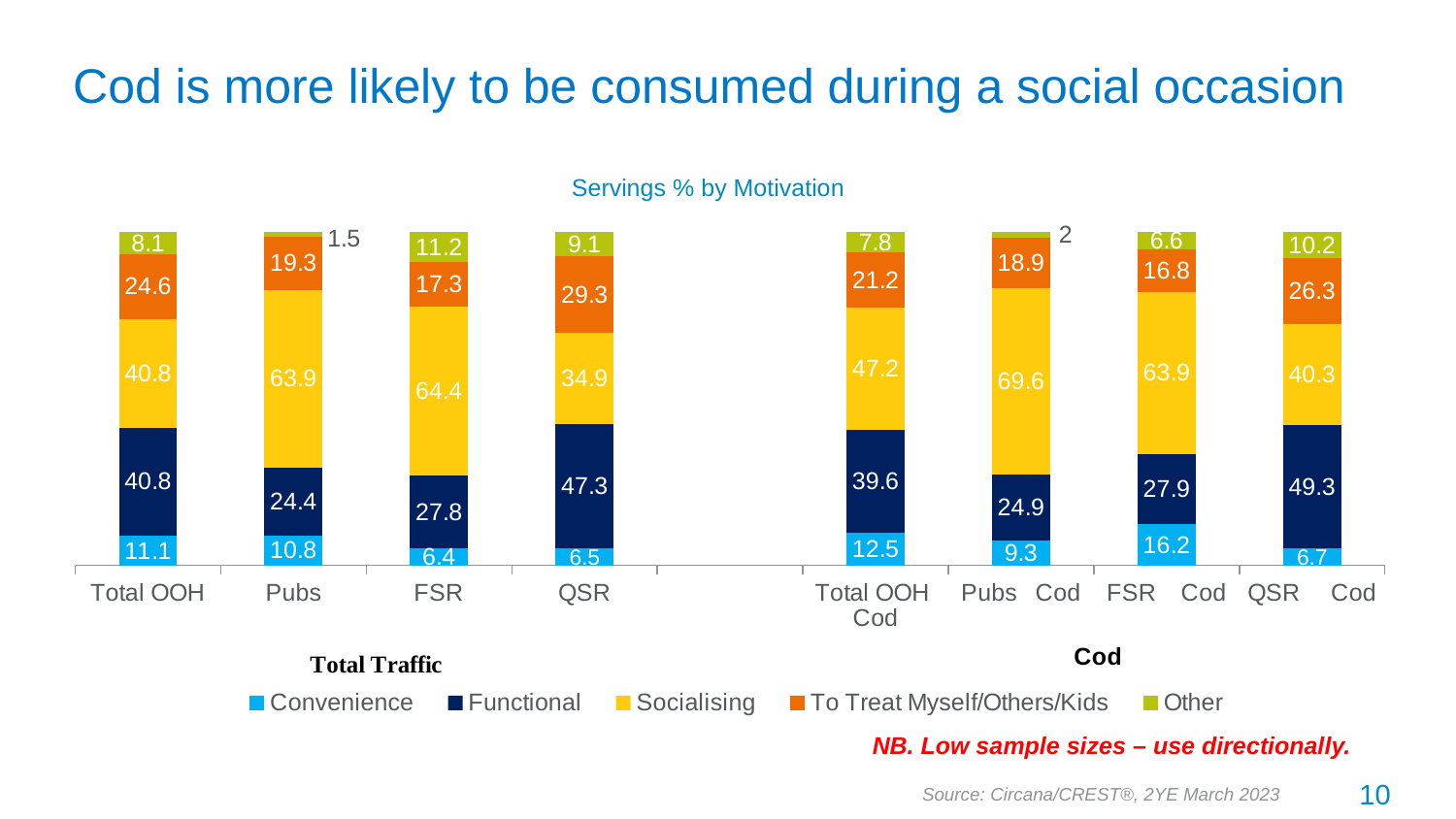
How many series does the legend list? 5 What kind of chart is shown on the slide? Stacked bar chart Which category has the highest Socialising value? Pubs Cod What is the Socialising value for Pubs? 63.9 What is the To Treat Myself/Others/Kids value for QSR? 29.3 Which has the larger Socialising value, Total OOH or Total OOH Cod? Total OOH Cod Which category has the lowest Convenience value? FSR What is the Convenience value for FSR Cod? 16.2 What is the difference between the Socialising values for Pubs Cod and Pubs? 5.7 How many categories are shown on the x axis? 8 What is the Functional value for QSR Cod? 49.3 What is the Other value for Pubs? 1.5